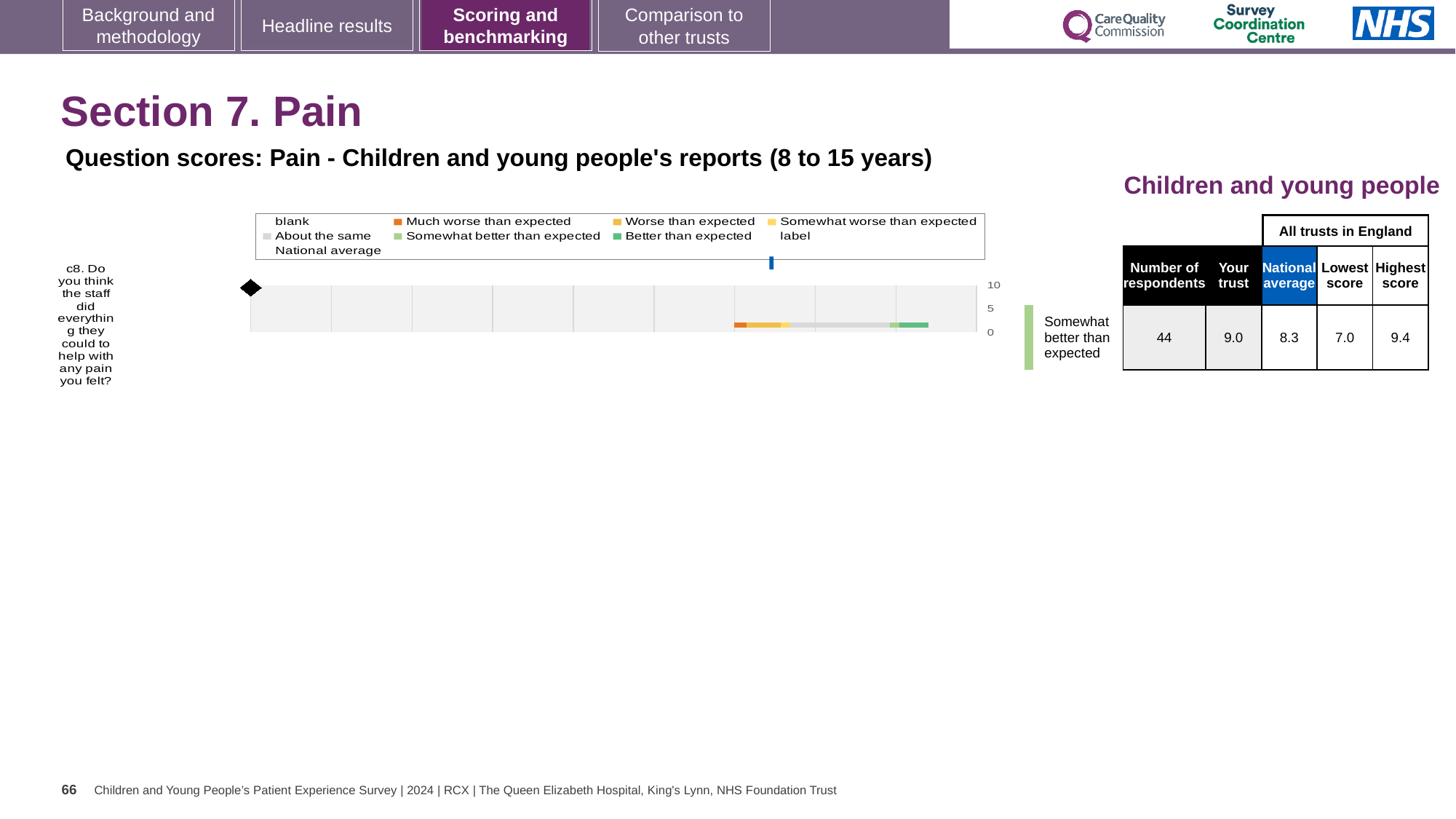
What kind of chart is shown on the slide for question c8? bar chart What is the highest score among all trusts in England for question c8? 9.4 Is the 'Your trust' score for question c8 larger or smaller than the national average? larger What is the national average score for question c8 in the table? 8.3 What benchmark category is shown for the trust on question c8? Somewhat better than expected How many questions (categories) are plotted in the chart? 1 What is the highest value shown on the chart's numeric axis? 10 How many respondents answered question c8? 44 What is the 'Your trust' score for question c8 in the table? 9.0 What is the lowest score among all trusts in England for question c8? 7.0 Which colour in the legend represents 'Much worse than expected'? orange What is the difference between the highest score and the lowest score for question c8? 2.4